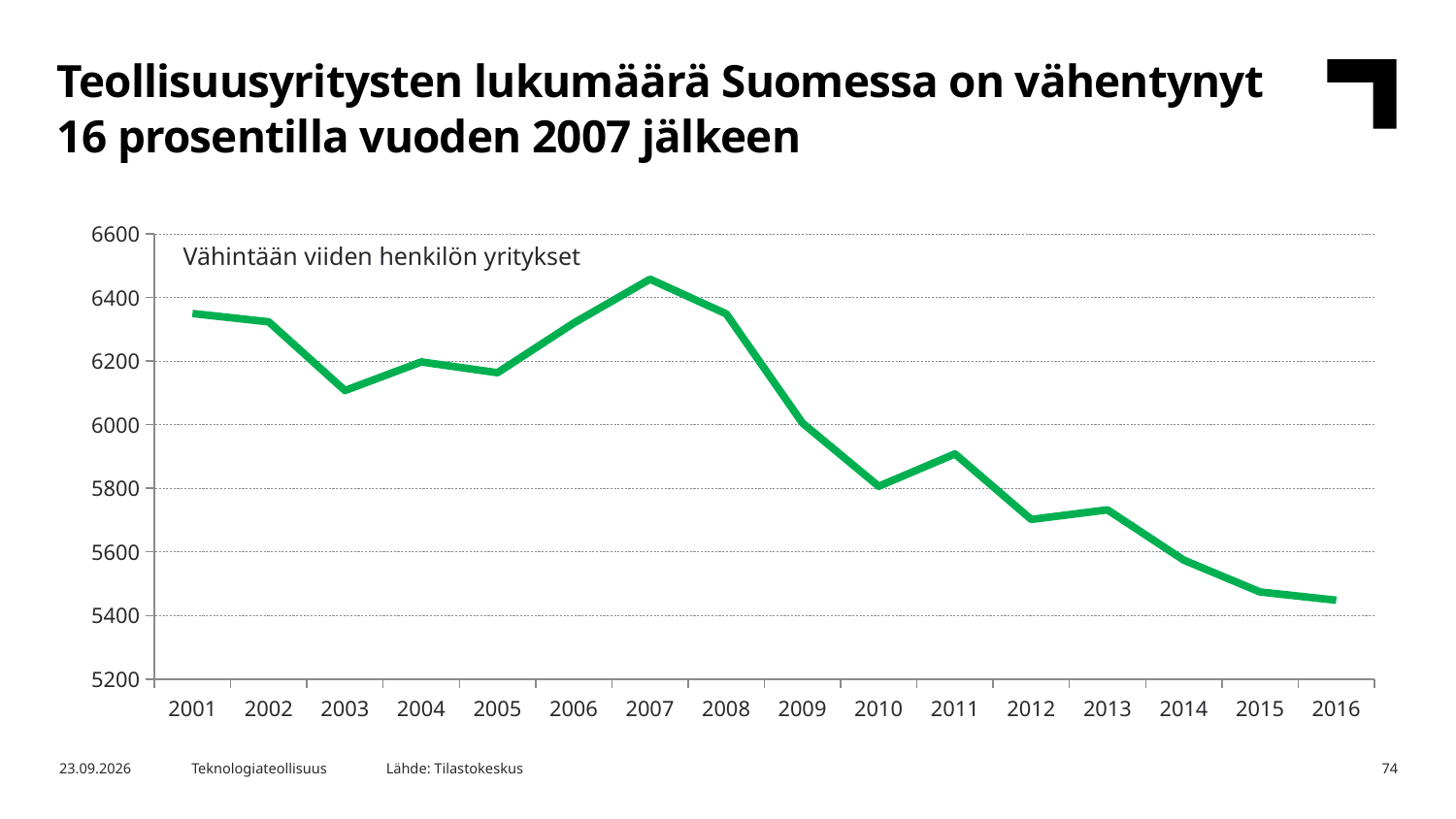
What text label appears inside the plot area of the chart? Vähintään viiden henkilön yritykset Is the value for 2016 greater or less than 5600? less Does the line generally rise or fall from 2007 to 2016? Fall What kind of chart is shown on the slide? Line chart In which year does the line reach its highest value? 2007 In which year does the line reach its lowest value? 2016 Is the value for 2003 greater or less than 6200? less Which year has the higher value, 2010 or 2011? 2011 Is the value for 2011 greater or less than 6000? less Which year has the higher value, 2003 or 2004? 2004 How many years are plotted on the x axis of the chart? 16